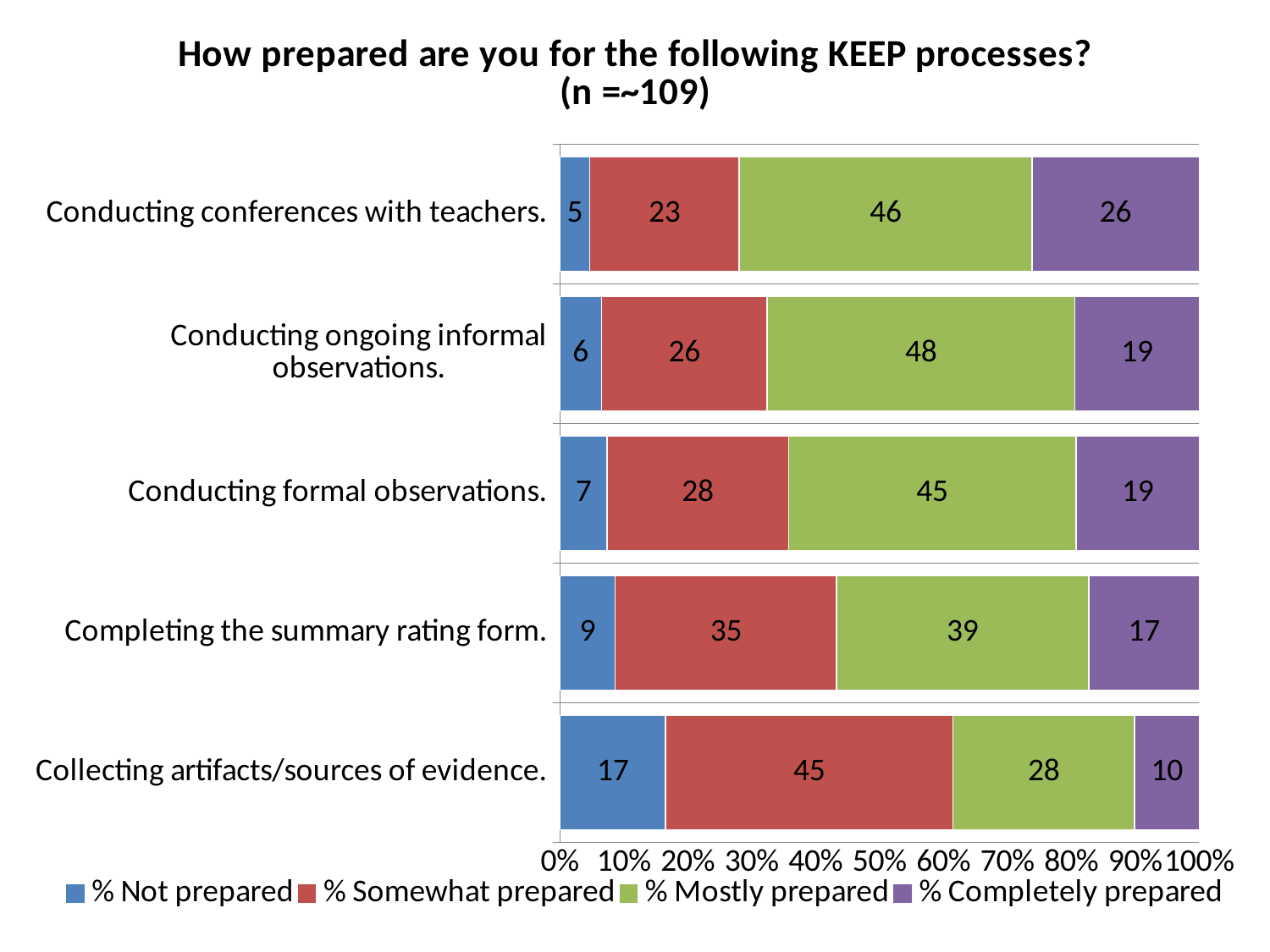
Which category has the highest value for "% Somewhat prepared"? Collecting artifacts/sources of evidence. What is the total of the stacked bar for "Conducting formal observations."? 99 What kind of chart is shown on the slide? Stacked bar chart What is the title of the chart? How prepared are you for the following KEEP processes? (n =~109) What is the value for "% Mostly prepared" for "Conducting conferences with teachers."? 46 How many categories are shown on the chart? 5 Which category has the lowest value for "% Completely prepared"? Collecting artifacts/sources of evidence. What is the value for "% Completely prepared" for "Completing the summary rating form."? 17 Which is larger: "% Completely prepared" for "Conducting conferences with teachers." or for "Conducting formal observations."? Conducting conferences with teachers. What is the difference between the "% Mostly prepared" values for "Conducting ongoing informal observations." and "Completing the summary rating form."? 9 How many series does the legend list? 4 What is the value for "% Not prepared" for "Collecting artifacts/sources of evidence."? 17